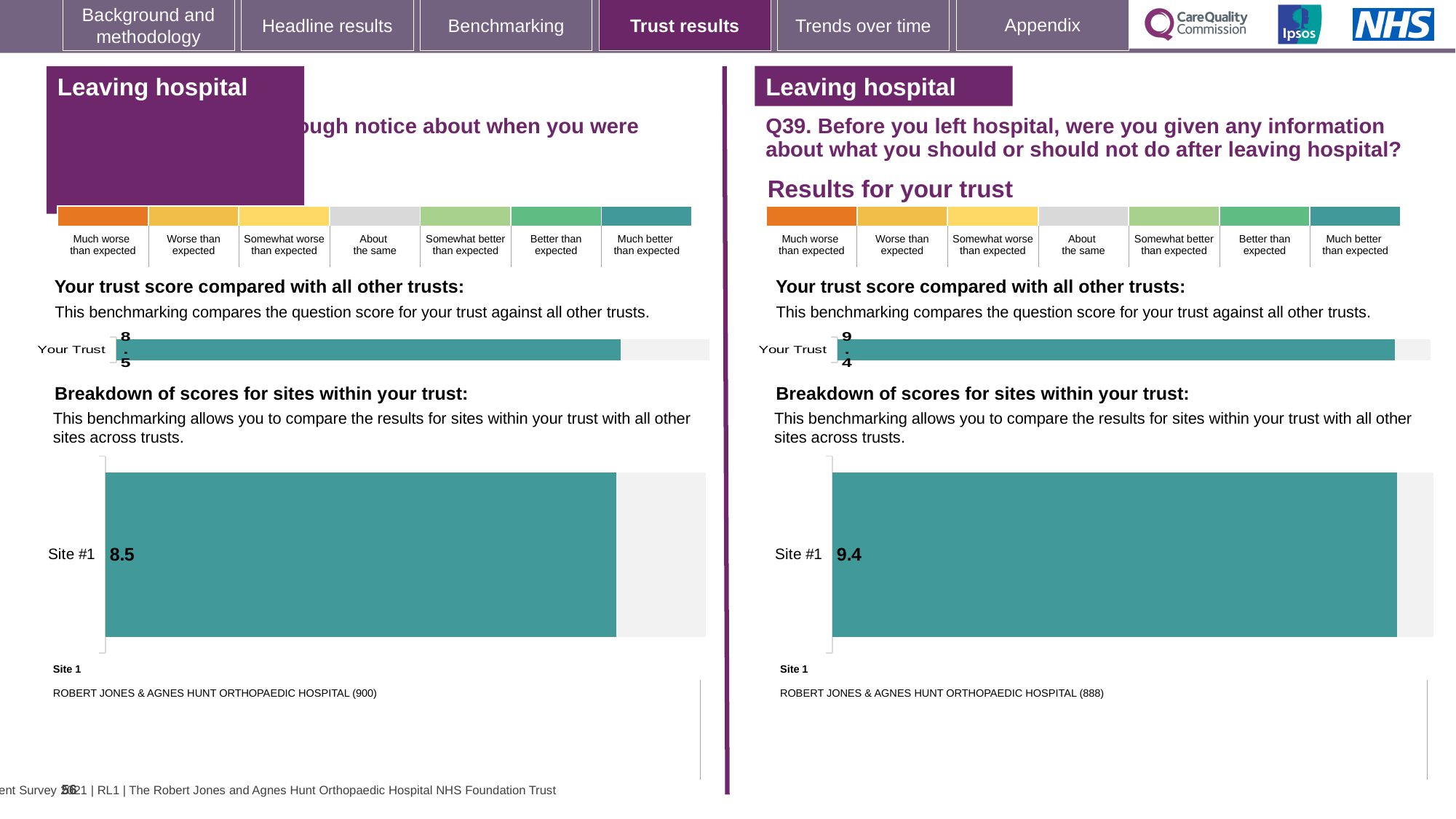
Which site name is listed as Site 1 under the right breakdown chart (Q39)? ROBERT JONES & AGNES HUNT ORTHOPAEDIC HOSPITAL (888) How many sites are shown in the left 'Breakdown of scores for sites within your trust' chart? 1 On the right half of the slide (Q39), what is the score shown for Your Trust in the 'Your trust score compared with all other trusts' chart? 9.4 How many sites are shown in the right 'Breakdown of scores for sites within your trust' chart (Q39)? 1 On the left half of the slide, what is the score shown for Your Trust in the 'Your trust score compared with all other trusts' chart? 8.5 How many categories does the colour key above the charts list, from 'Much worse than expected' to 'Much better than expected'? 7 In the left 'Breakdown of scores for sites within your trust' chart, what is the score for Site #1? 8.5 What type of chart is used to show the Your Trust score on the left half of the slide? Bar chart Which is larger: the Your Trust score on the left half of the slide or the Your Trust score on the right half (Q39)? The right half (Q39) What type of chart is used to show the Site #1 score in the right breakdown chart (Q39)? Bar chart In the right 'Breakdown of scores for sites within your trust' chart (Q39), what is the score for Site #1? 9.4 What is the difference between the Site #1 score in the right breakdown chart (Q39) and the Site #1 score in the left breakdown chart? 0.9